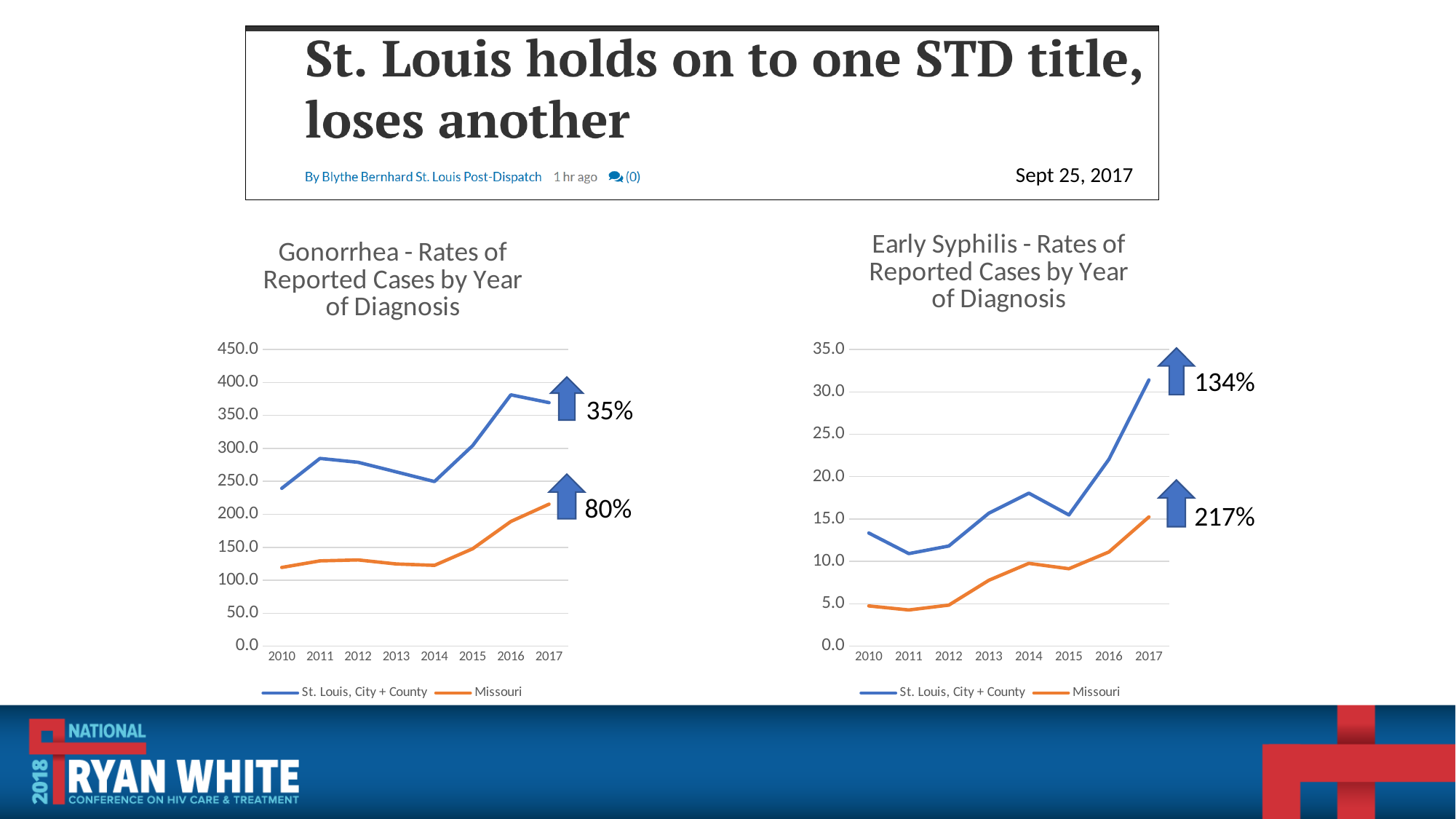
In the Gonorrhea chart, which year has the highest value for St. Louis, City + County? 2016 In the Gonorrhea chart, is the 2016 value for St. Louis, City + County greater or less than 350? greater In the Early Syphilis chart, does the St. Louis, City + County line rise or fall from 2015 to 2017? rise In the Gonorrhea chart, what percentage is printed next to the arrow beside the Missouri line? 80% In the Early Syphilis chart, which year has the highest value for St. Louis, City + County? 2017 In the Early Syphilis chart, is the 2017 value for St. Louis, City + County greater or less than 30? greater What kind of chart is the Gonorrhea - Rates of Reported Cases by Year of Diagnosis chart? line chart In the Gonorrhea chart, is the 2010 value for Missouri greater or less than 150? less How many series does the legend of the Early Syphilis chart list? 2 In the Early Syphilis chart, which series has the larger value in 2017, St. Louis, City + County or Missouri? St. Louis, City + County How many years are shown on the x axis of the Gonorrhea chart? 8